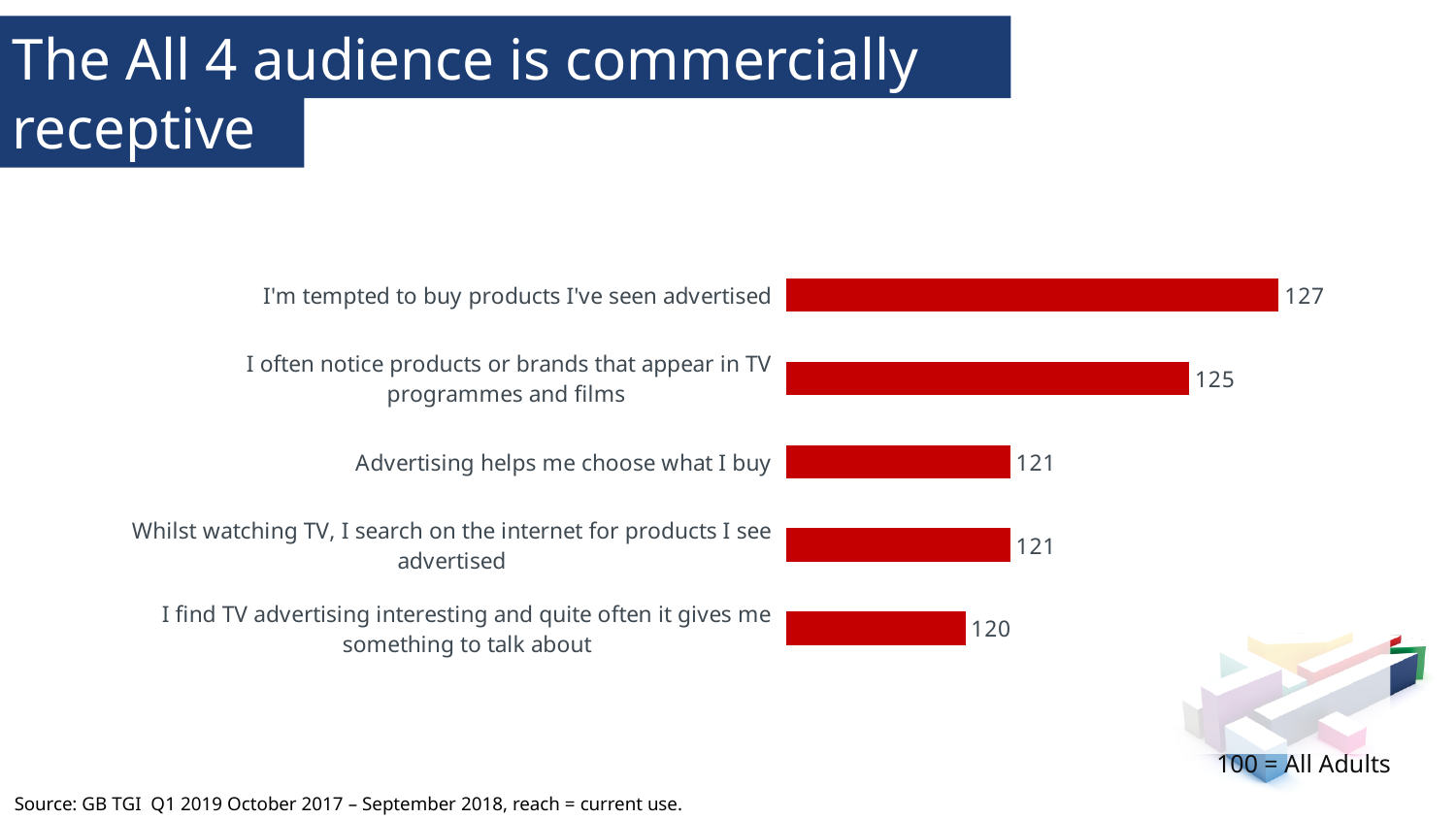
What is the difference between the values for "I'm tempted to buy products I've seen advertised" and "I find TV advertising interesting and quite often it gives me something to talk about"? 7 What is the value for "I find TV advertising interesting and quite often it gives me something to talk about"? 120 What is the value for "Advertising helps me choose what I buy"? 121 What is the difference between the values for "I often notice products or brands that appear in TV programmes and films" and "Advertising helps me choose what I buy"? 4 What is the value for "I often notice products or brands that appear in TV programmes and films"? 125 What is the value for "I'm tempted to buy products I've seen advertised"? 127 How many statements are shown in the chart? 5 According to the slide, what does an index value of 100 represent? All Adults Which statement has the lowest value? I find TV advertising interesting and quite often it gives me something to talk about Which has a larger value: "I'm tempted to buy products I've seen advertised" or "Advertising helps me choose what I buy"? I'm tempted to buy products I've seen advertised What kind of chart is shown on the slide? Bar chart Which statement has the highest value? I'm tempted to buy products I've seen advertised